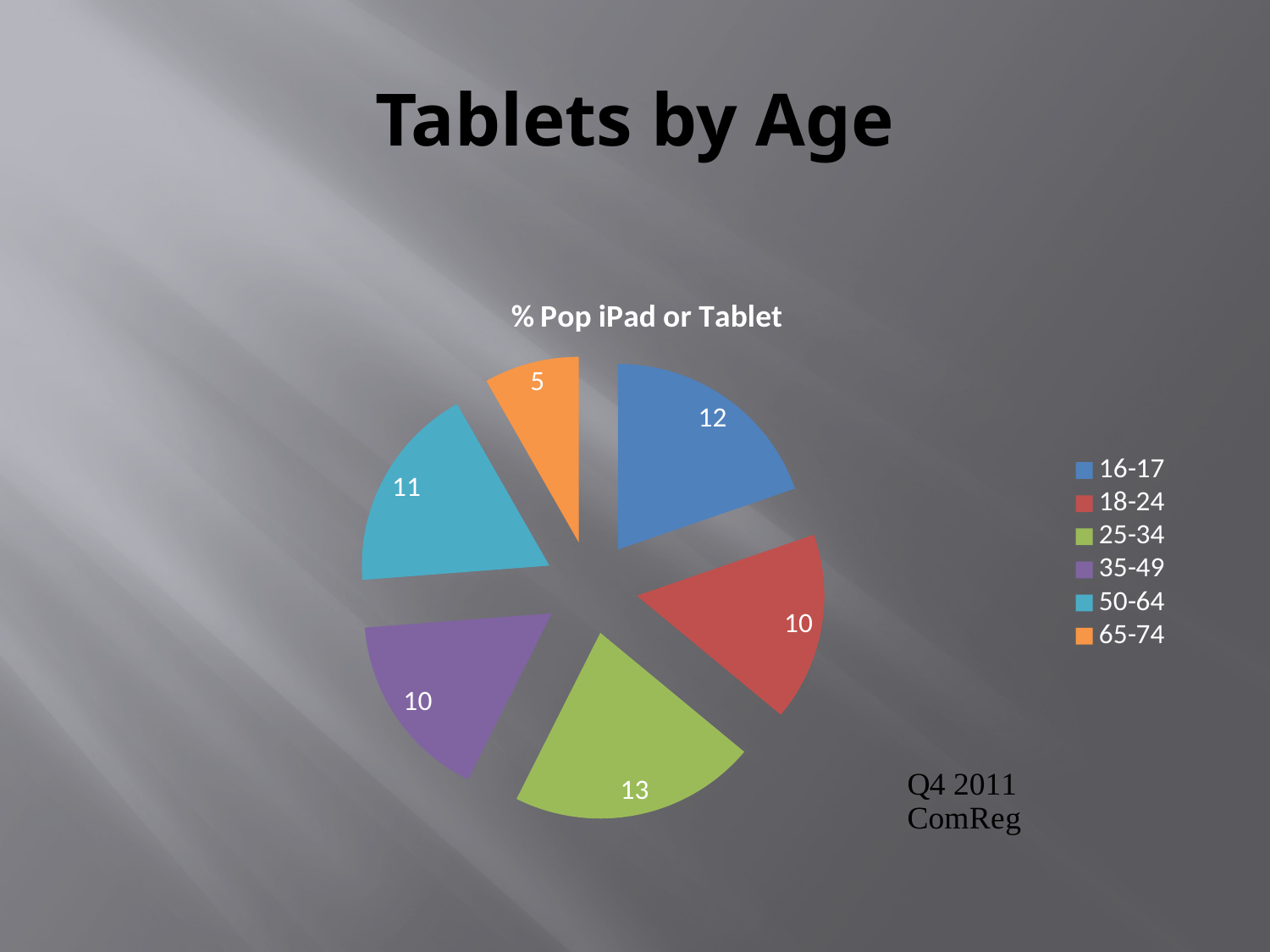
What kind of chart is shown on the slide? Pie chart Which age group has the smallest slice of the pie? 65-74 What is the difference between the values for the 25-34 and 65-74 age groups? 8 Which has the larger value, the 16-17 age group or the 50-64 age group? 16-17 What is the title of the chart? % Pop iPad or Tablet What is the value shown for the 65-74 age group? 5 What is the value shown for the 50-64 age group? 11 How many entries does the legend list? 6 Which age group has the largest slice of the pie? 25-34 What is the value shown for the 16-17 age group? 12 How many age groups are shown in the pie chart? 6 What is the value shown for the 25-34 age group? 13